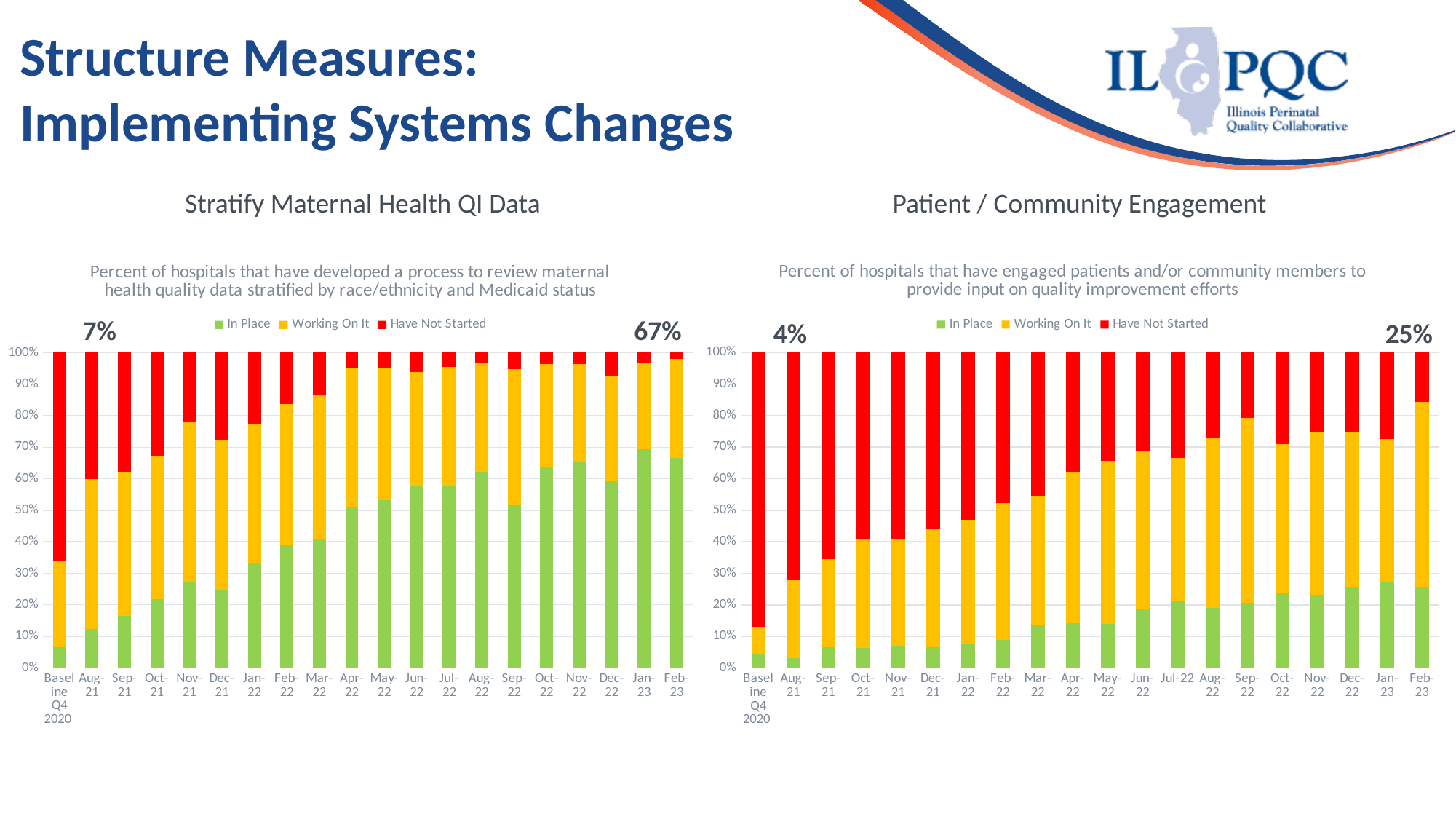
On the Stratify Maternal Health QI Data chart, is the In Place value for Jan-23 greater or less than 60%? greater On the Stratify Maternal Health QI Data chart, by how many percentage points did the labelled In Place value increase from Baseline Q4 2020 to Feb-23? 60 percentage points On the Patient / Community Engagement chart, by how many percentage points did the labelled In Place value increase from Baseline Q4 2020 to Feb-23? 21 percentage points On the Stratify Maternal Health QI Data chart, what is the labelled In Place value for Feb-23? 67% On the Patient / Community Engagement chart, what is the labelled In Place value at Baseline Q4 2020? 4% On the Patient / Community Engagement chart, what is the labelled In Place value for Feb-23? 25% How many time periods are shown on the x axis of the Stratify Maternal Health QI Data chart? 20 How many series does the legend of the Patient / Community Engagement chart list? 3 On the Patient / Community Engagement chart, is the In Place value for Aug-21 greater or less than 10%? less Which chart shows the larger labelled In Place value for Feb-23, Stratify Maternal Health QI Data or Patient / Community Engagement? Stratify Maternal Health QI Data On the Stratify Maternal Health QI Data chart, what is the labelled In Place value at Baseline Q4 2020? 7% What kind of chart is the Patient / Community Engagement chart? Stacked bar chart